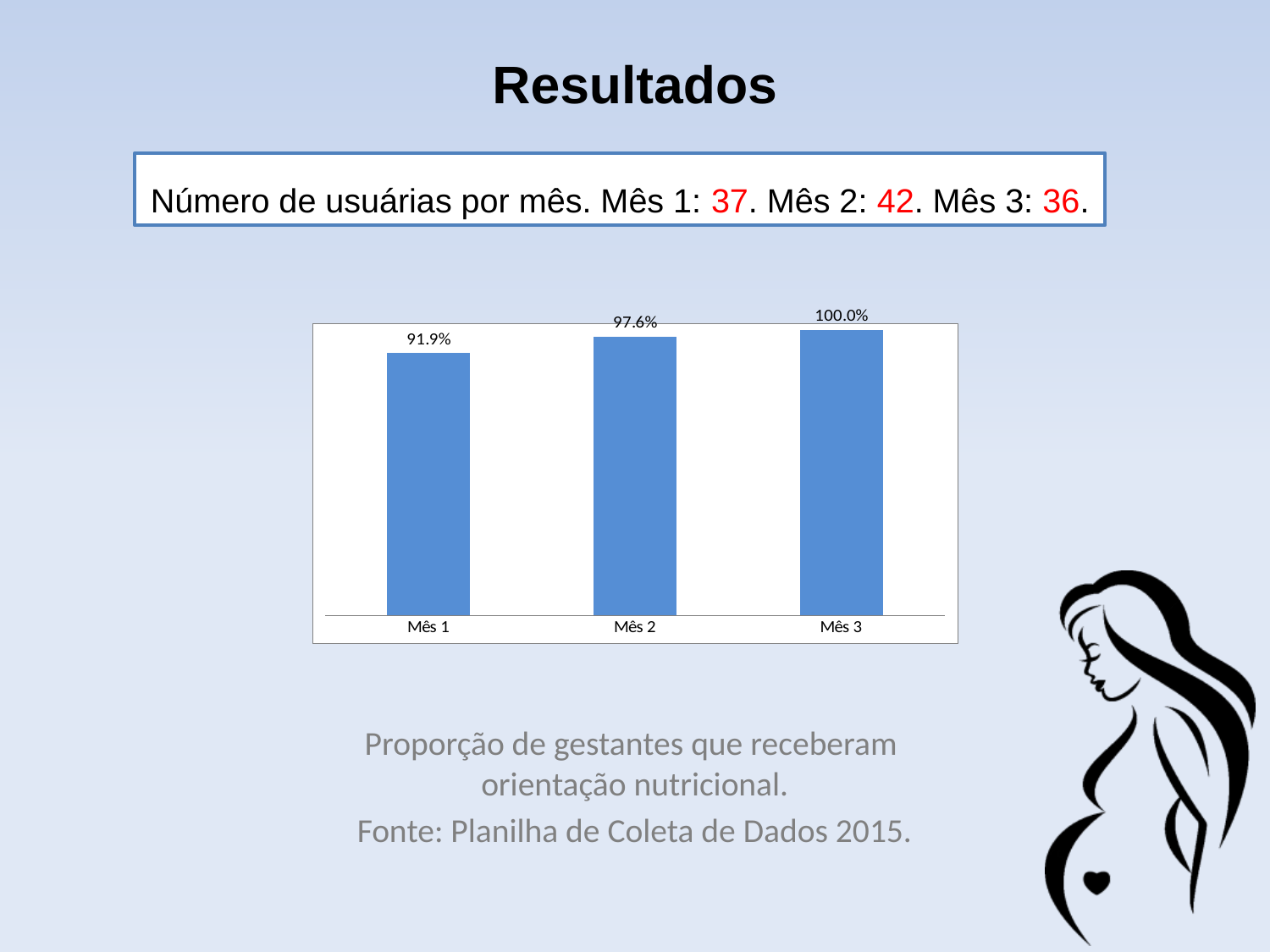
What is the value for Mês 1? 91.9% Which is larger, the value for Mês 1 or the value for Mês 2? Mês 2 What is the difference between the values for Mês 3 and Mês 1? 8.1% What is the value for Mês 3? 100.0% What kind of chart is shown on the slide? Bar chart Do the values rise or fall from Mês 1 to Mês 3? Rise What is the difference between the values for Mês 2 and Mês 1? 5.7% What is the value for Mês 2? 97.6% Which month has the highest value? Mês 3 How many months are shown on the chart? 3 Which month has the lowest value? Mês 1 What does the caption below the chart say the chart shows? Proporção de gestantes que receberam orientação nutricional.